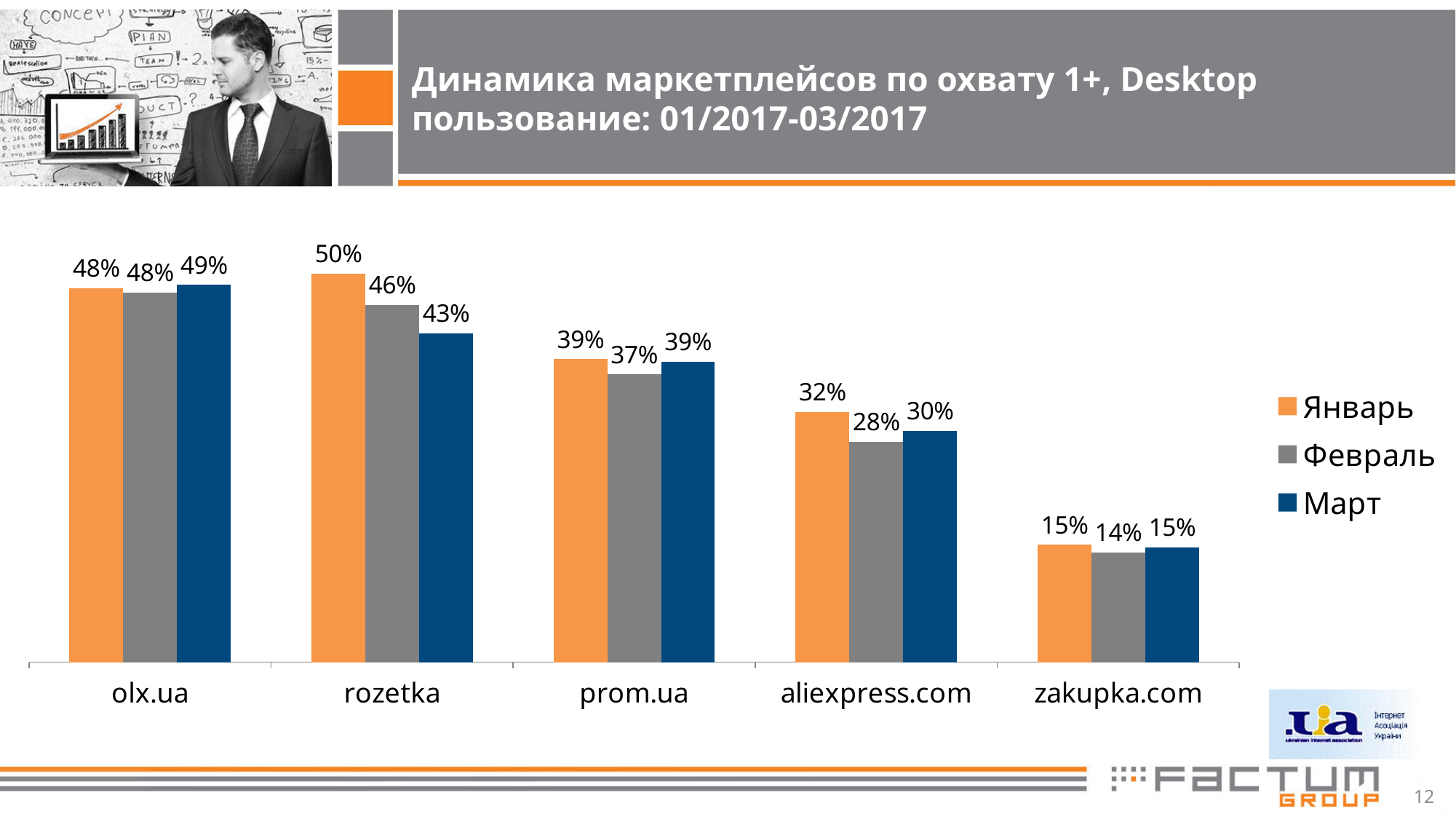
What is the value for aliexpress.com in Февраль? 28% How many marketplaces are shown on the x axis? 5 Do the values for rozetka rise or fall from Январь to Март? fall Which marketplace has the highest value in Январь? rozetka Which colour represents Февраль in the legend? grey What is the difference between the Январь and Март values for rozetka? 7% Which is larger: the Март value for olx.ua or the Март value for rozetka? olx.ua What kind of chart is shown on the slide? bar chart Which marketplace has the lowest value in Март? zakupka.com What is the value for rozetka in Январь? 50% What is the value for zakupka.com in Март? 15% How many series does the legend list? 3